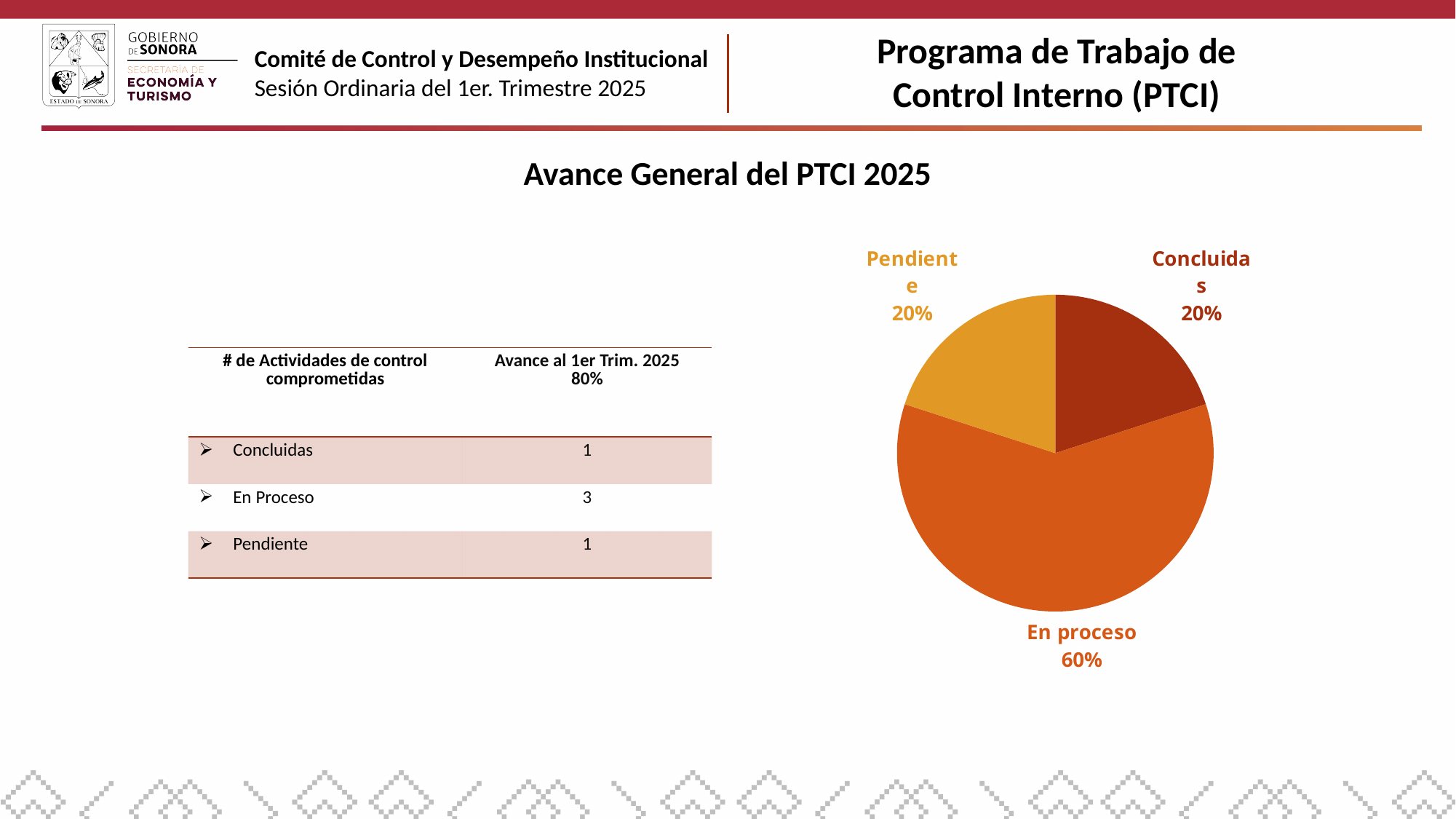
What is the title shown above the chart and table? Avance General del PTCI 2025 Which is larger in the pie chart, "En proceso" or "Pendiente"? En proceso What colour is the "En proceso" slice of the pie chart? orange What share of the pie chart is labelled "Pendiente"? 20% Is the share for "En proceso" greater or less than 50%? greater What share of the pie chart is labelled "En proceso"? 60% What share of the pie chart is labelled "Concluidas"? 20% What kind of chart is shown on the slide? pie chart What is the combined share of the "Concluidas" and "Pendiente" slices? 40% Which slice of the pie chart is the largest? En proceso How many slices does the pie chart have? 3 What is the difference in percentage points between the "En proceso" slice and the "Concluidas" slice? 40%